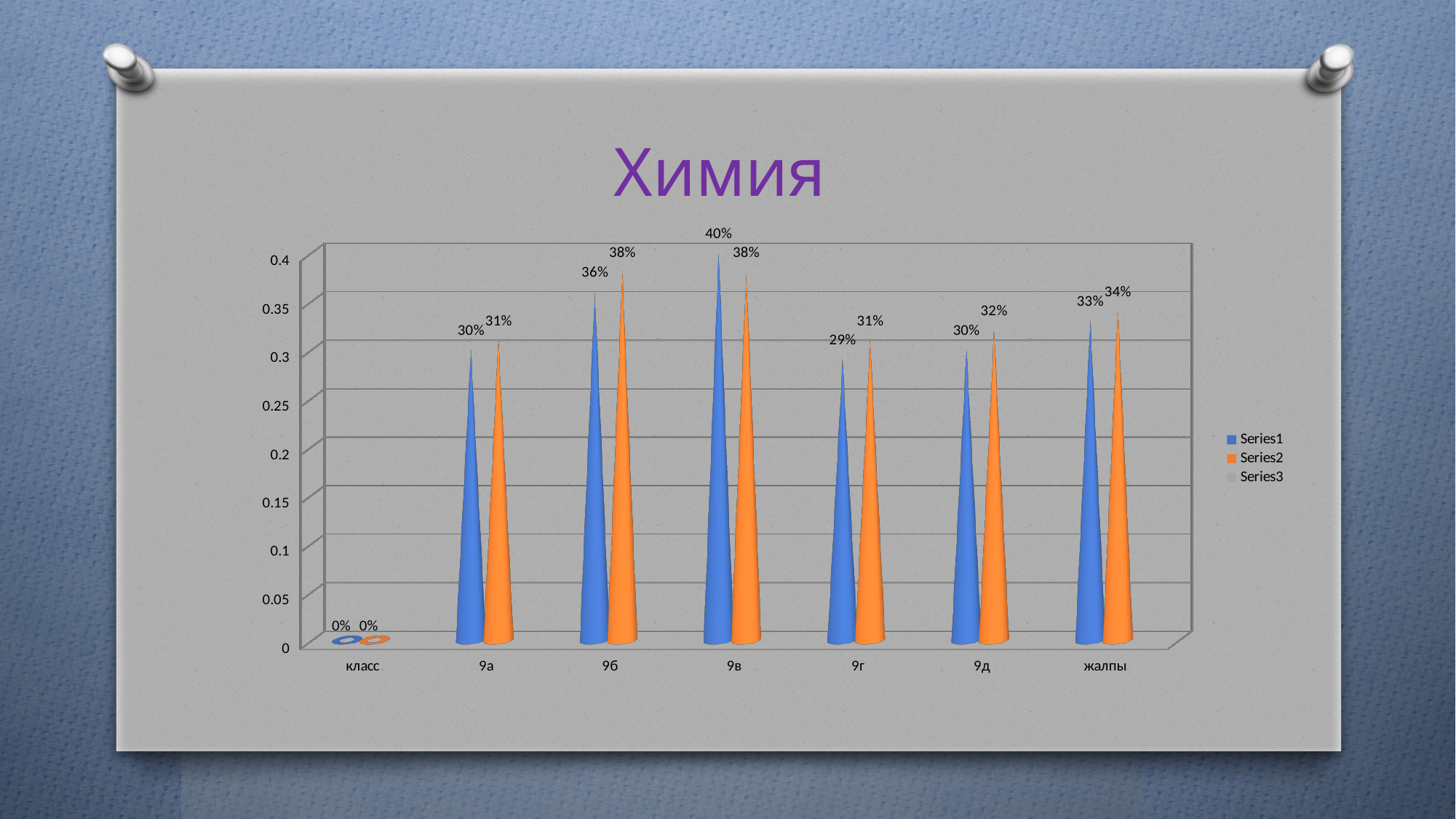
What is the Series1 value for жалпы? 33% How many categories are shown on the x axis? 7 How many series does the legend list? 3 What is the difference between the Series2 and Series1 values for 9б? 2% What is the Series2 value for 9д? 32% What kind of chart is shown on the slide? bar chart What is the Series1 value for 9в? 40% Which is larger for 9в: the Series1 value or the Series2 value? Series1 What is the title of the slide? Химия Among the classes 9а to 9д, which has the lowest Series1 value? 9г Is the Series2 value for 9г greater or less than 0.35? less Which category has the highest Series1 value? 9в